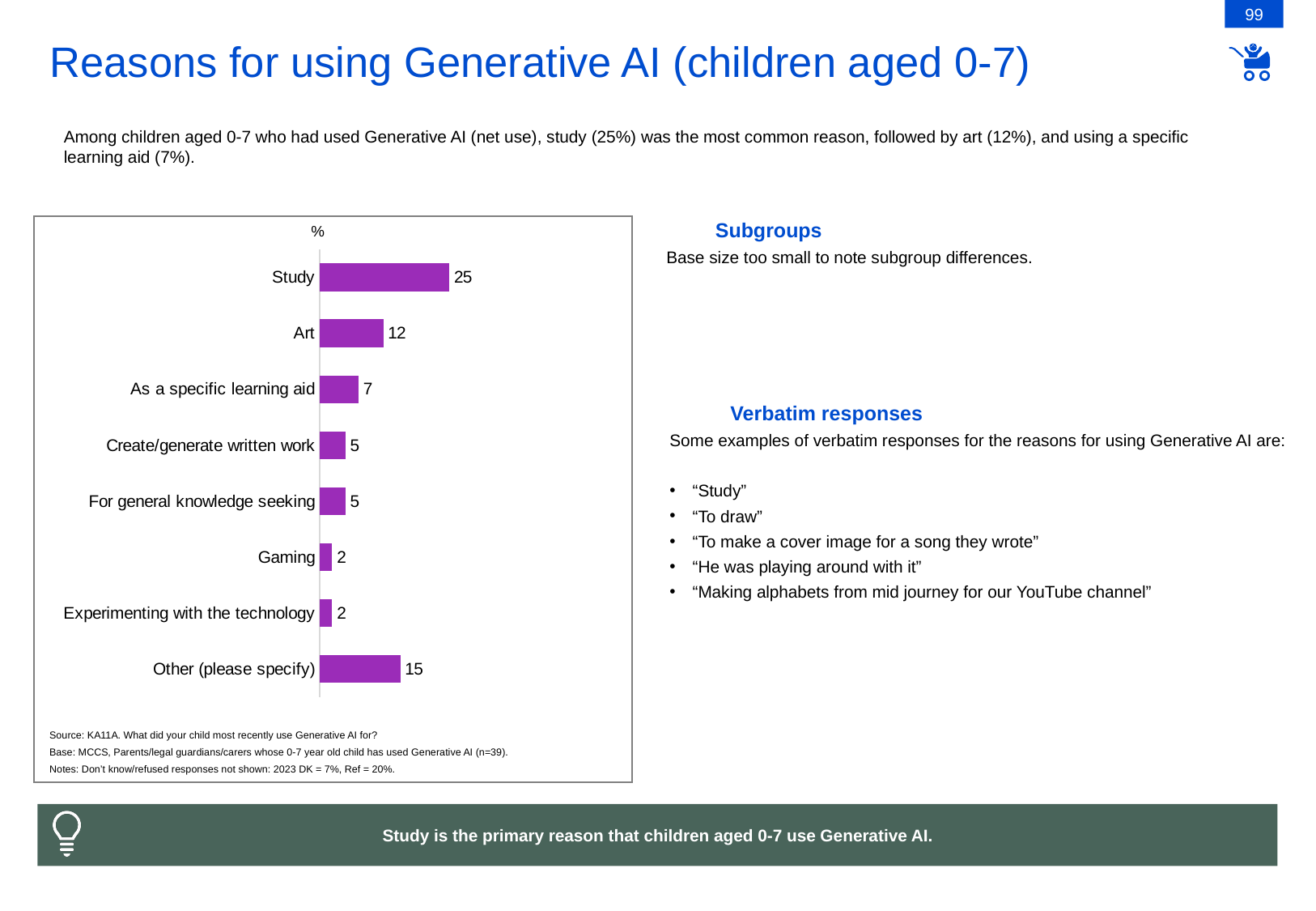
What is the value for As a specific learning aid? 7 How many categories are shown in the chart? 8 What is the difference between the values for Study and Art? 13 What colour are the bars in the chart? Purple Which category has the highest value? Study What is the value for Study? 25 What unit is indicated at the top of the chart's axis? % What is the value for Art? 12 Which is larger, the value for Other (please specify) or the value for Art? Other (please specify) What kind of chart is shown on the slide? Bar chart What is the difference between the values for Create/generate written work and Gaming? 3 What is the value for Other (please specify)? 15